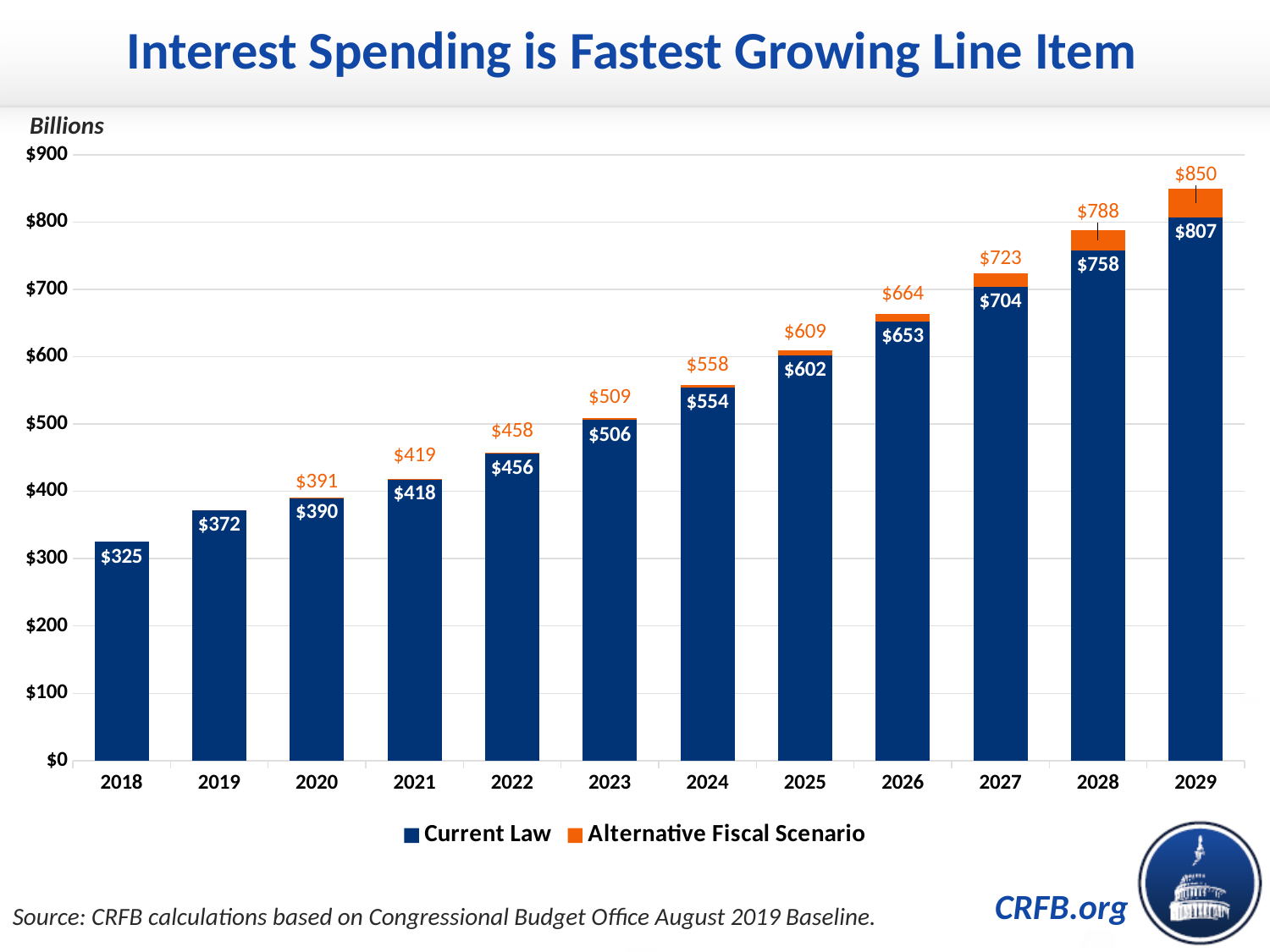
What is the Alternative Fiscal Scenario total shown above the 2029 bar? $850 Which is larger, the Current Law value for 2024 or for 2023? 2024 What is the difference between the Current Law values for 2029 and 2018? $482 What is the difference between the Alternative Fiscal Scenario total ($850) and the Current Law value ($807) for 2029? $43 How many years are shown on the x axis? 12 Do the Current Law values rise or fall from 2018 to 2029? Rise What is the Current Law value for 2018? $325 Which year has the highest Current Law value? 2029 What kind of chart is shown on the slide? Bar chart How many series does the legend list? 2 Which year has the lowest Current Law value? 2018 What is the Current Law value for 2025? $602